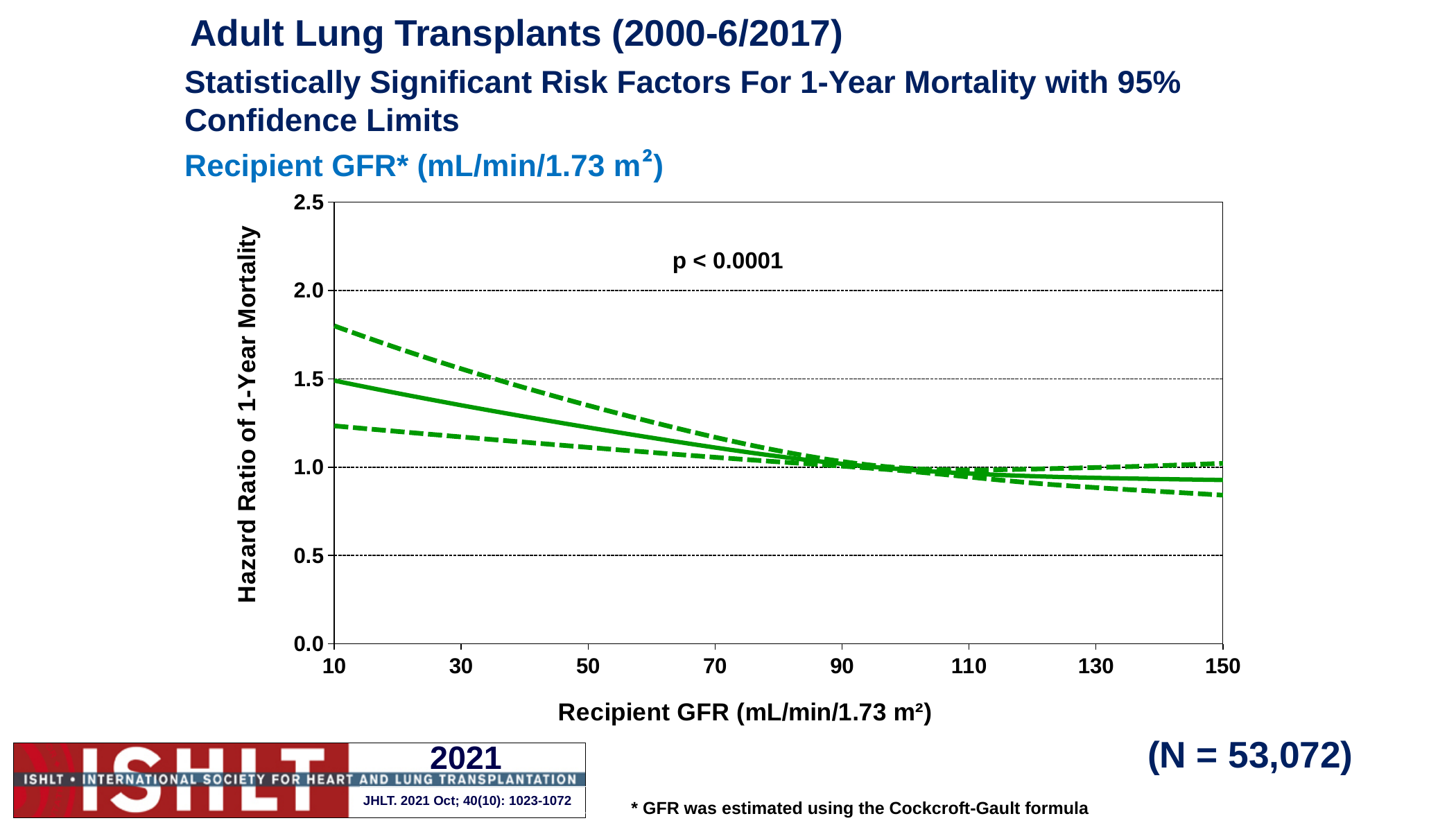
What p-value is printed on the chart? p < 0.0001 Is the upper 95% confidence limit (upper dashed line) at a recipient GFR of 10 greater or less than 1.5? greater What kind of chart is shown on the slide? line chart What is the sample size (N) shown on the slide? 53,072 Is the hazard ratio (solid line) at a recipient GFR of 10 greater or less than 1.0? greater Is the lower 95% confidence limit (lower dashed line) at a recipient GFR of 10 greater or less than 1.0? greater What is the highest value shown on the y-axis? 2.5 How many lines are plotted on the chart? 3 Does the hazard ratio of 1-year mortality rise or fall as recipient GFR increases from 10 to 150? fall What is the label of the y-axis? Hazard Ratio of 1-Year Mortality